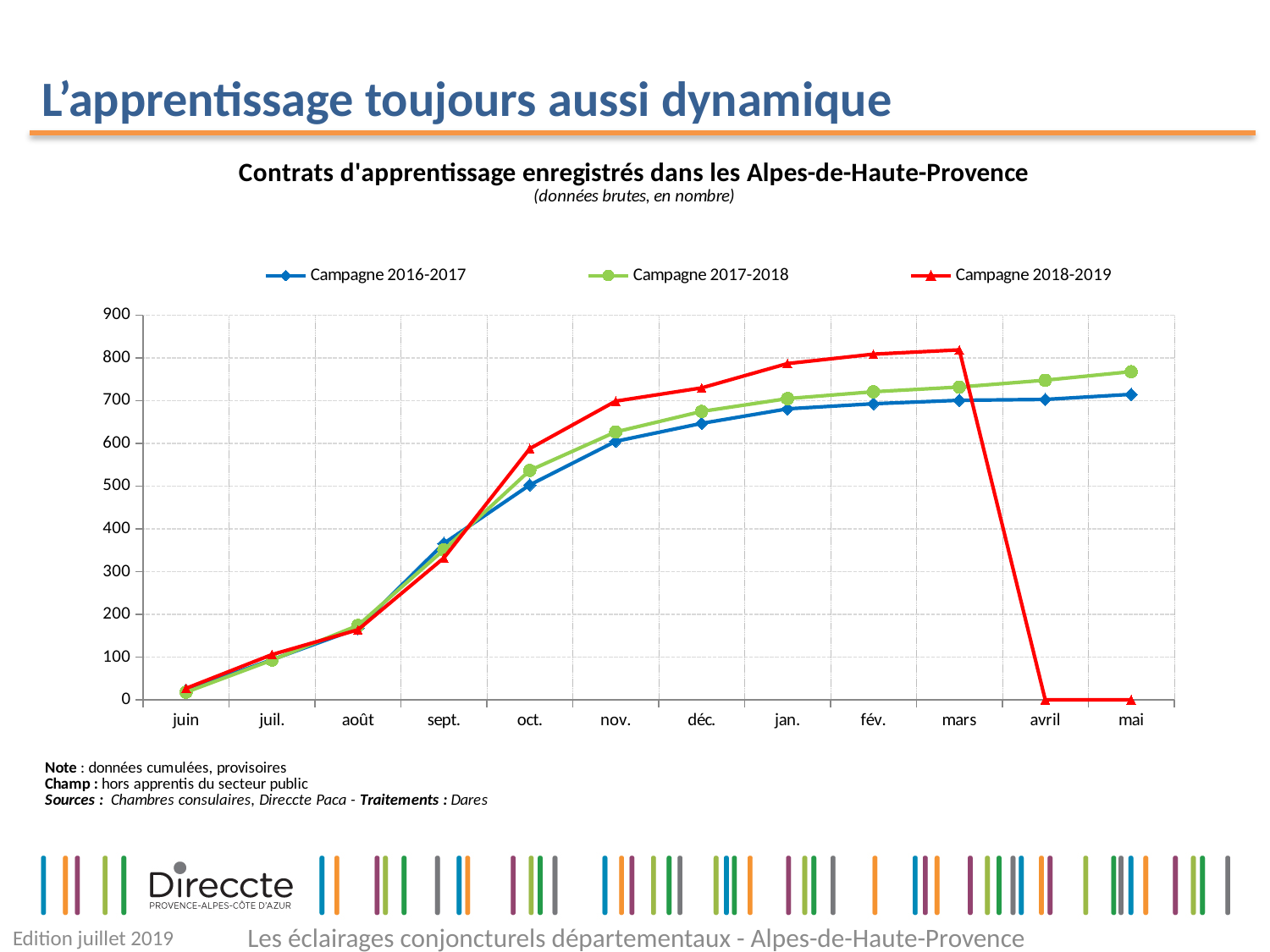
Does the Campagne 2017-2018 series rise or fall from juin to mai? rise Is the value for Campagne 2016-2017 in oct. greater or less than 600? less Is the value for Campagne 2016-2017 in mai greater or less than 800? less What is the title of the chart? Contrats d'apprentissage enregistrés dans les Alpes-de-Haute-Provence Is the value for Campagne 2017-2018 in mai greater or less than 700? greater How many months are shown along the x axis? 12 In mai, which series has the larger value: Campagne 2017-2018 or Campagne 2016-2017? Campagne 2017-2018 In mars, which series has the larger value: Campagne 2018-2019 or Campagne 2016-2017? Campagne 2018-2019 How many series does the legend list? 3 What kind of chart is shown on the slide? line chart